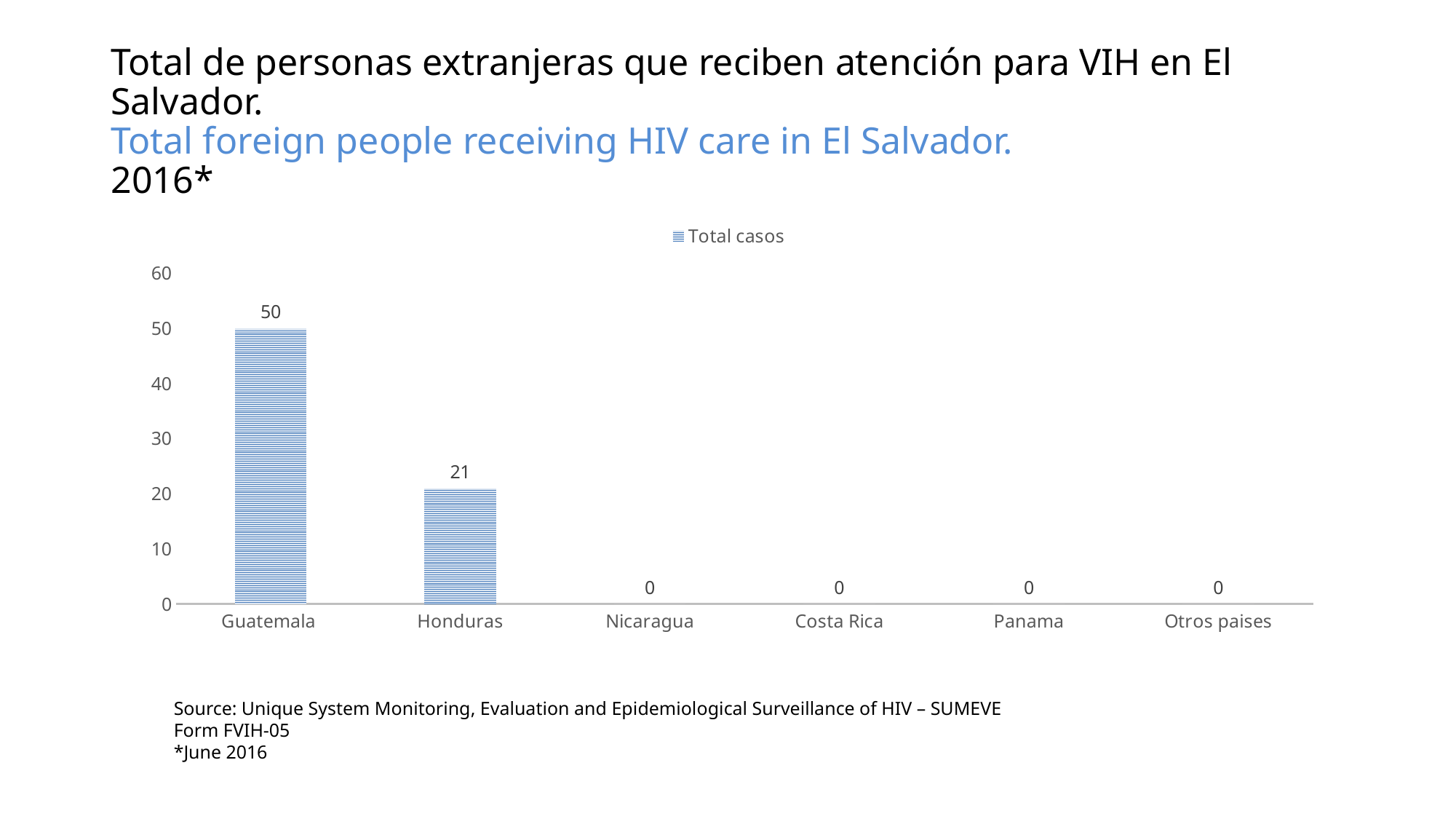
What kind of chart is shown on the slide? bar chart Is the value for Honduras greater or less than 30? less Which is larger, the value for Guatemala or the value for Honduras? Guatemala What is the value for Otros paises? 0 What is the difference between the values for Guatemala and Honduras? 29 What is the value for Honduras? 21 What is the value for Nicaragua? 0 What is the name of the series shown in the legend? Total casos What is the value for Guatemala? 50 How many series does the legend list? 1 How many categories are shown on the x axis? 6 Which category has the highest value? Guatemala